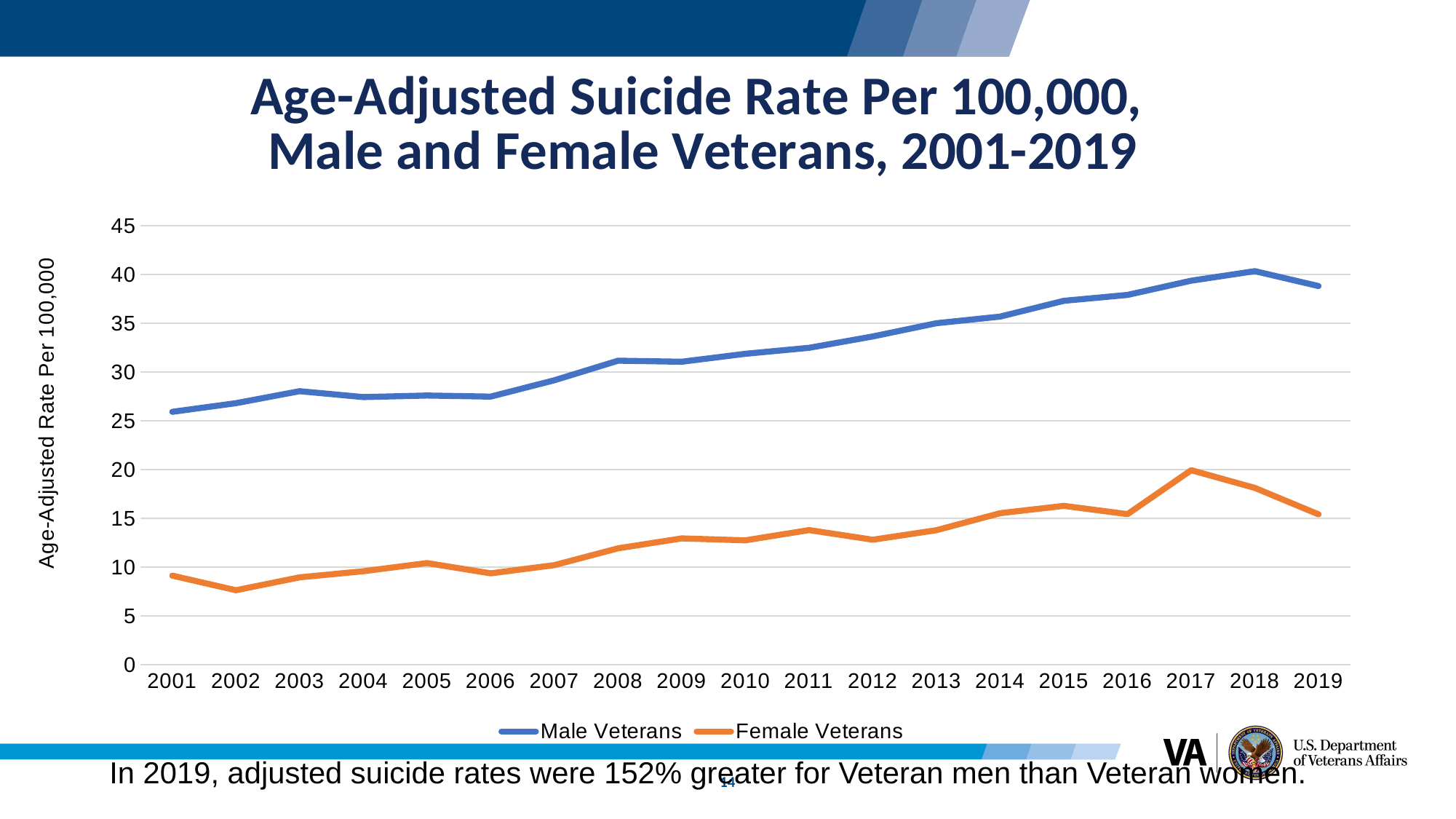
Which series has the larger value in 2019, Male Veterans or Female Veterans? Male Veterans In which year is the Female Veterans rate lowest? 2002 What kind of chart is shown on the slide? line chart Does the Male Veterans line generally rise or fall from 2001 to 2019? rise Is the value for Female Veterans in 2002 greater or less than 10? less In which year is the Male Veterans rate highest? 2018 Is the value for Male Veterans in 2001 greater or less than 30? less How many years are plotted along the x axis? 19 In which year is the Female Veterans rate highest? 2017 How many series does the legend list? 2 In which year is the Male Veterans rate lowest? 2001 Is the value for Male Veterans in 2019 greater or less than 35? greater